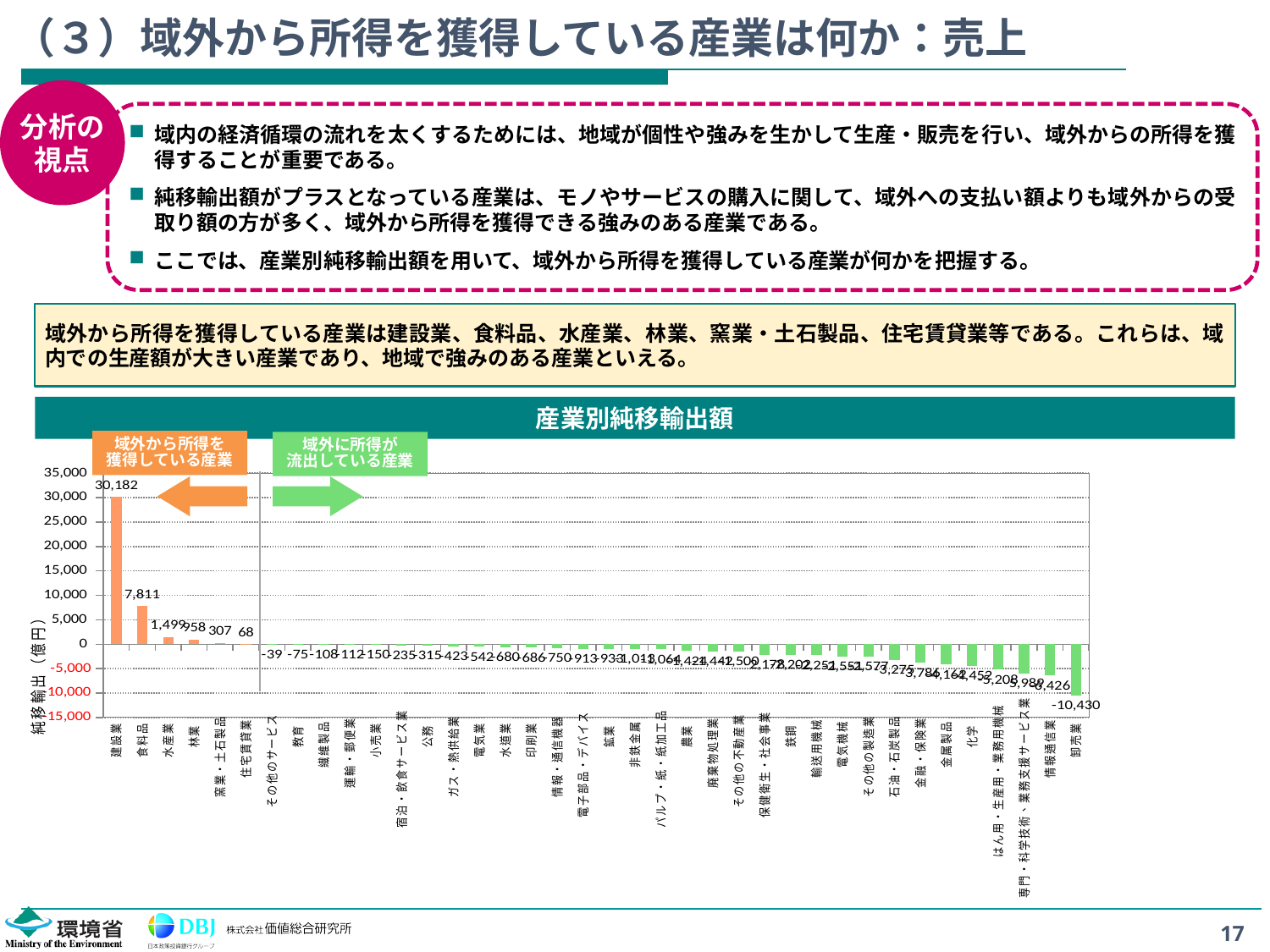
What kind of chart is shown on the slide? bar chart Do the values rise or fall moving from left to right along the x axis? fall What is the difference between the values for 建設業 and 食料品? 22,371 Which industry has the lowest value? 卸売業 What is the value for 食料品? 7,811 What is the title of the chart? 産業別純移輸出額 Which industry has the highest value? 建設業 Is the value for 卸売業 greater or less than -10,000? less Which is larger, the value for 食料品 or the value for 水産業? 食料品 What is the value for 卸売業? -10,430 What is the value for 水産業? 1,499 What is the value for 建設業? 30,182